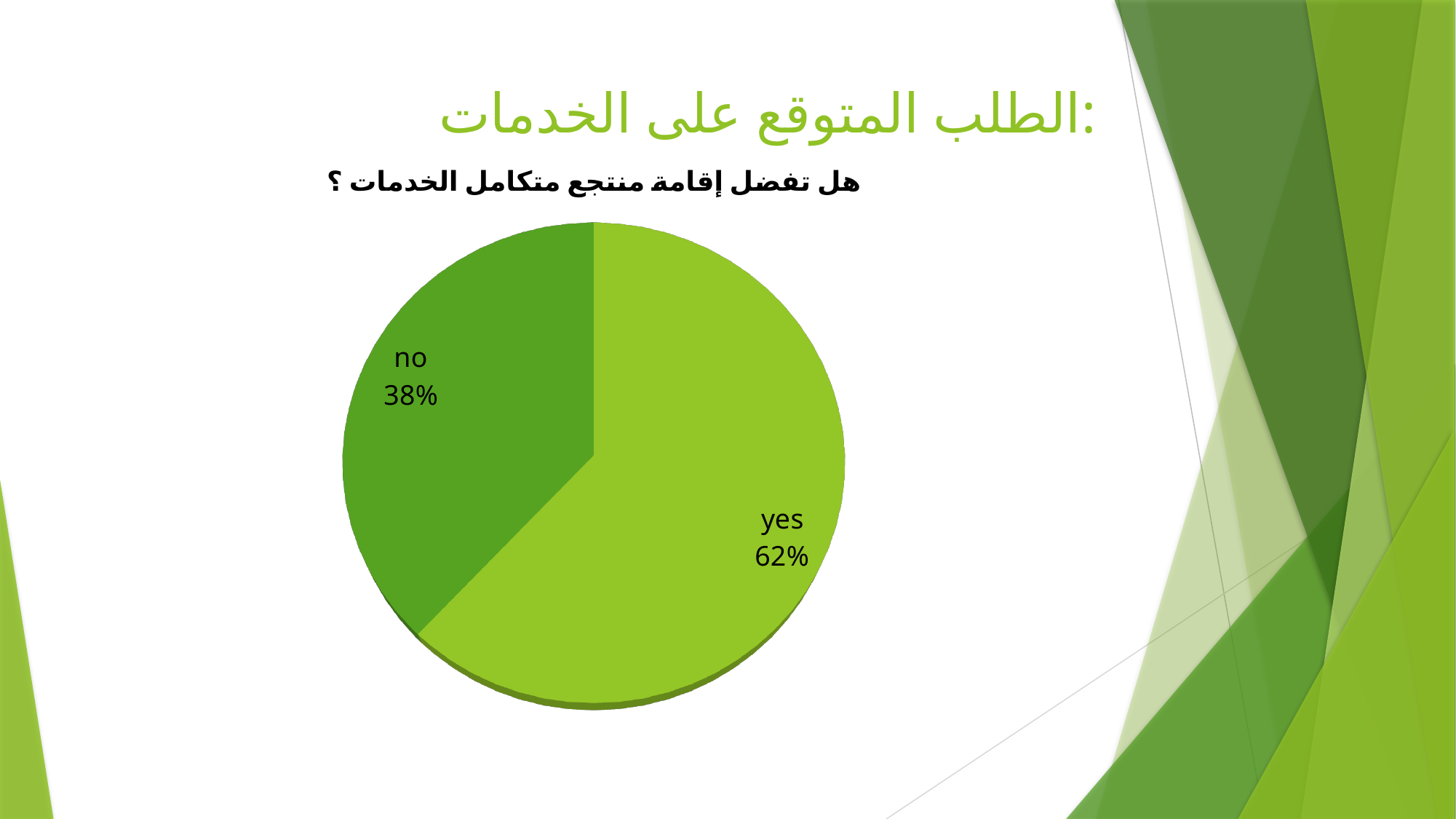
What share of the pie does the "yes" slice represent? 62% Is the share for "no" greater or less than 50%? less Which slice of the pie is the smallest? no Which slice is shown in the darker green colour? no What kind of chart is shown on the slide? pie chart Is the share for "yes" greater or less than 50%? greater What is the difference in percentage points between the "yes" and "no" slices? 24 Which is larger, the "yes" slice or the "no" slice? yes What is the title of the pie chart? هل تفضل إقامة منتجع متكامل الخدمات ؟ Which slice of the pie is the largest? yes How many slices does the pie chart have? 2 What share of the pie does the "no" slice represent? 38%